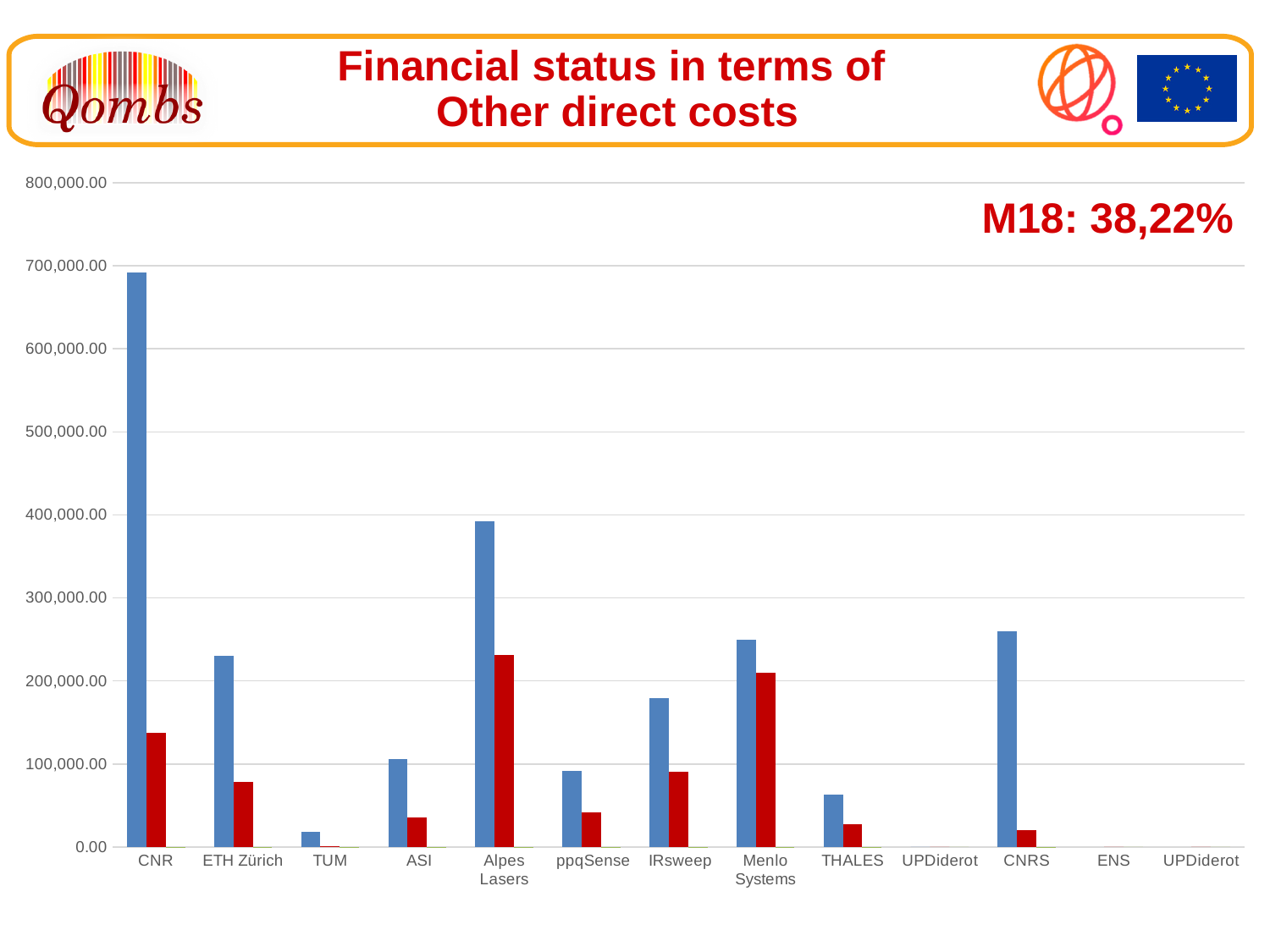
Is the blue bar for IRsweep greater or less than 200,000.00? less What kind of chart is shown on the slide? bar chart How many categories are shown along the x axis of the chart? 13 Which category has the tallest blue bar? CNR Is the blue bar for TUM greater or less than 100,000.00? less Is the blue bar for CNR greater or less than 600,000.00? greater Which is larger, the red bar for Alpes Lasers or the red bar for CNR? Alpes Lasers Which is larger, the blue bar for CNR or the blue bar for Alpes Lasers? CNR What percentage is shown in the annotation labelled M18 on the chart? 38,22%